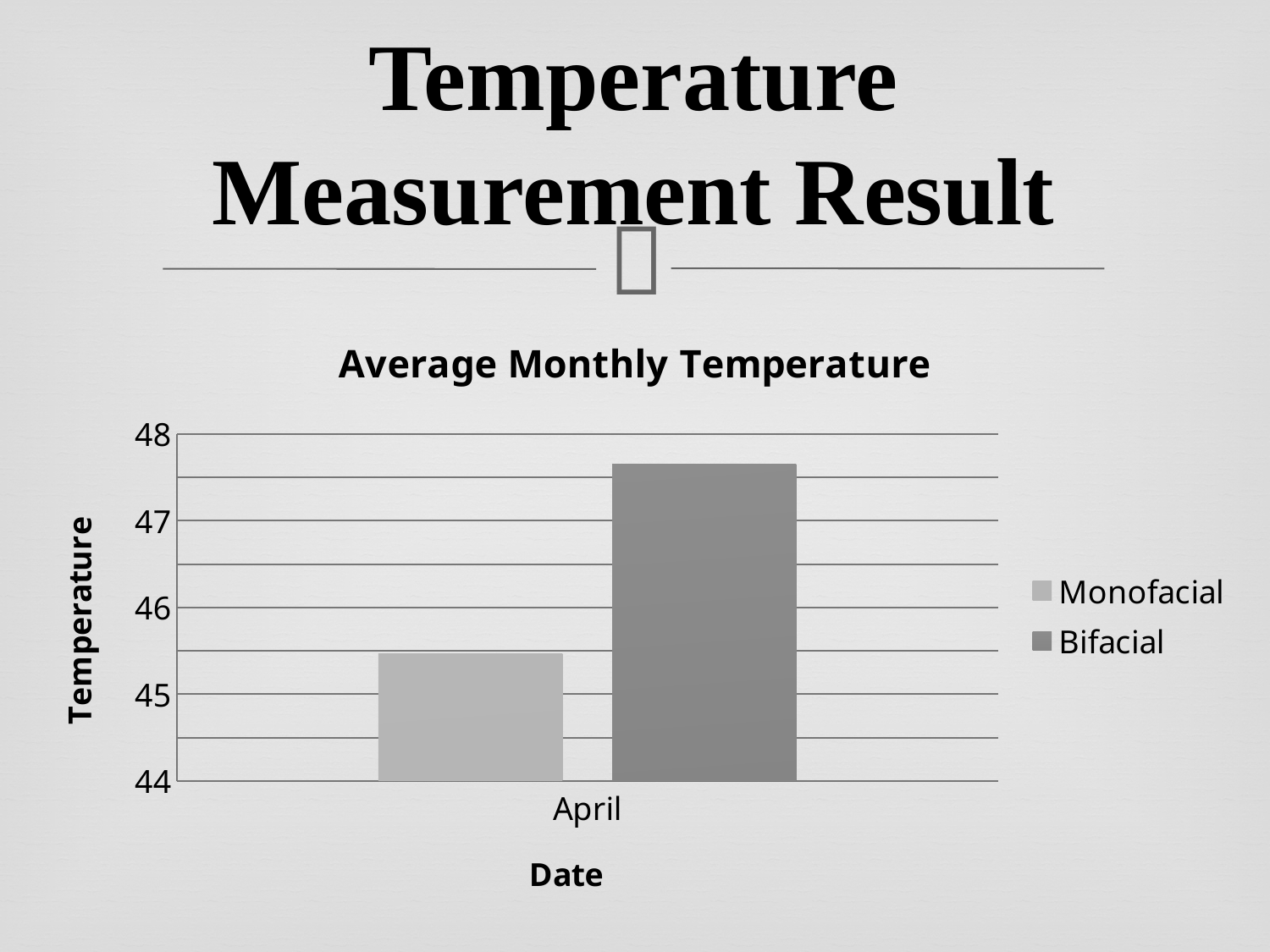
Which series has the lowest value for April? Monofacial How many series does the legend list? 2 Which month is shown on the x axis? April Is the value for Monofacial in April greater or less than 46? less What is the title of the chart? Average Monthly Temperature Which series are listed in the legend? Monofacial, Bifacial Is the value for Bifacial in April greater or less than 48? less What kind of chart is shown on the slide? bar chart Which series has the higher value for April? Bifacial How many categories are shown on the x axis? 1 Is the value for Bifacial in April greater or less than 47? greater